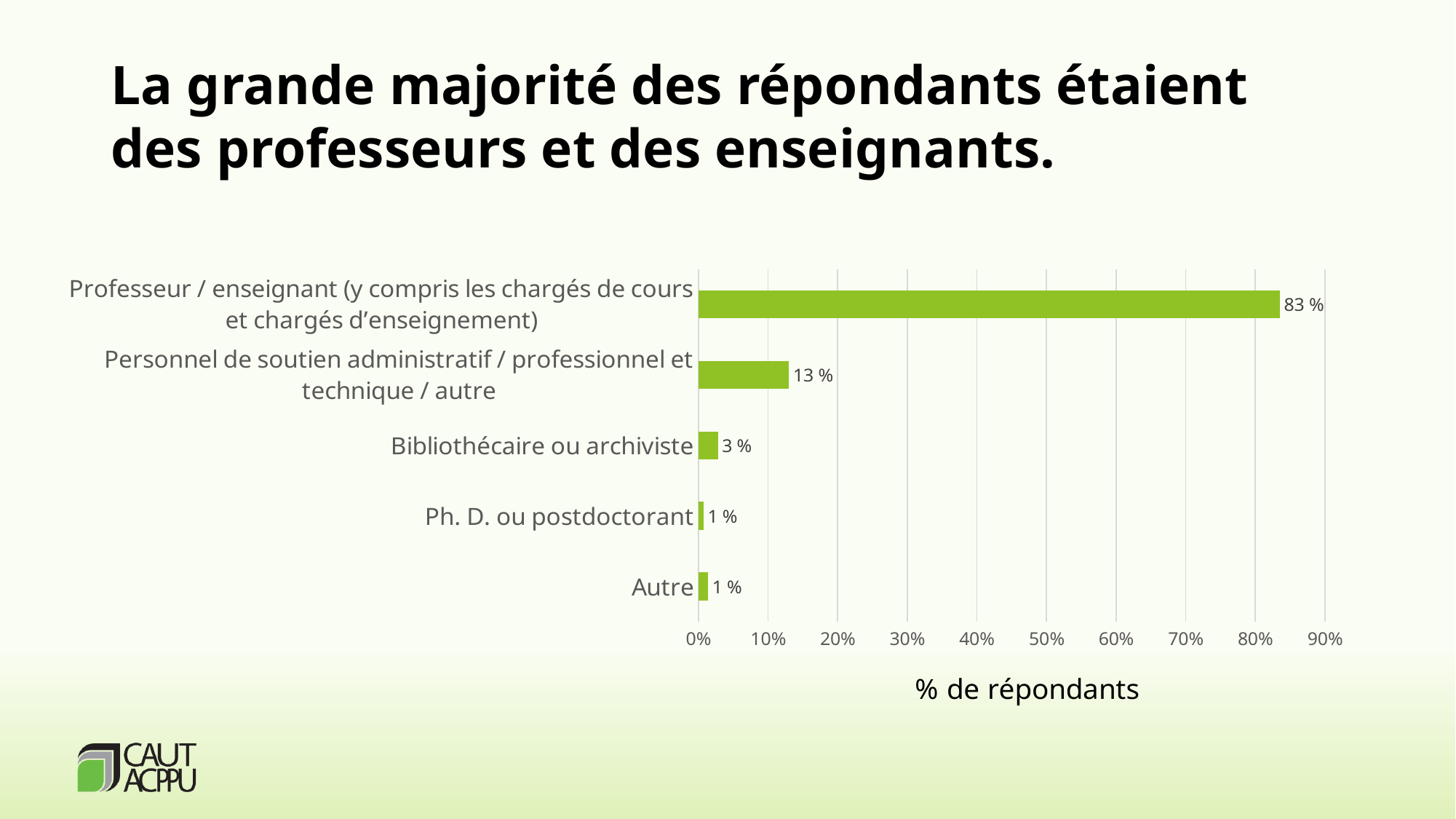
What is the highest tick value shown on the horizontal axis? 90% What percentage of respondents were Bibliothécaire ou archiviste? 3 % What is the label of the horizontal axis? % de répondants Is the value for Personnel de soutien administratif / professionnel et technique / autre greater or less than 20%? less How many categories are shown in the chart? 5 What kind of chart is shown on the slide? Bar chart What is the value for Ph. D. ou postdoctorant? 1 % Which is larger: the value for Bibliothécaire ou archiviste or the value for Autre? Bibliothécaire ou archiviste What is the difference between the Professeur / enseignant value and the Personnel de soutien administratif / professionnel et technique / autre value? 70 % What percentage of respondents were Professeur / enseignant (y compris les chargés de cours et chargés d'enseignement)? 83 % What is the value for Personnel de soutien administratif / professionnel et technique / autre? 13 % Which category has the highest percentage of respondents? Professeur / enseignant (y compris les chargés de cours et chargés d'enseignement)